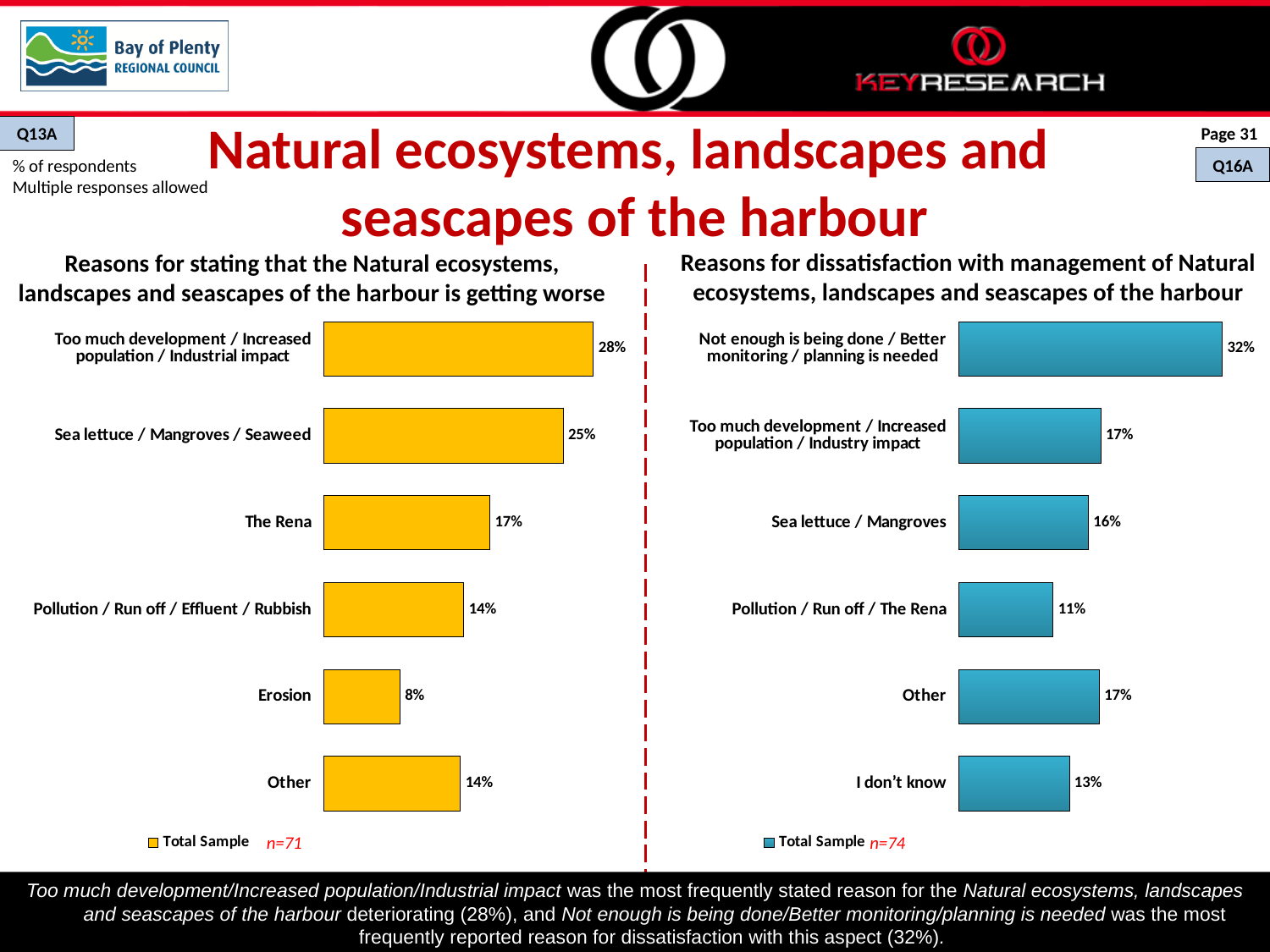
In the right chart (reasons for dissatisfaction with management), what is the difference between Not enough is being done / Better monitoring / planning is needed and Too much development / Increased population / Industry impact? 15% In the right chart (reasons for dissatisfaction with management), which category has the highest value? Not enough is being done / Better monitoring / planning is needed In the right chart (Reasons for dissatisfaction with management), what is the value for Pollution / Run off / The Rena? 11% What kind of chart is the right chart (reasons for dissatisfaction with management)? Bar chart In the left chart (reasons for getting worse), which category has the highest value? Too much development / Increased population / Industrial impact In the right chart (reasons for dissatisfaction with management), which is larger: Sea lettuce / Mangroves or I don't know? Sea lettuce / Mangroves In the left chart (reasons for getting worse), what is the difference between The Rena and Erosion? 9% In the left chart (reasons for getting worse), how many categories are shown? 6 In the left chart (reasons for getting worse), which category has the lowest value? Erosion How many series does the legend of the left chart (reasons for getting worse) list? 1 In the left chart (Reasons for stating that the Natural ecosystems, landscapes and seascapes of the harbour is getting worse), what is the value for Sea lettuce / Mangroves / Seaweed? 25% What is the sample size (n) shown for the right chart (reasons for dissatisfaction with management)? n=74